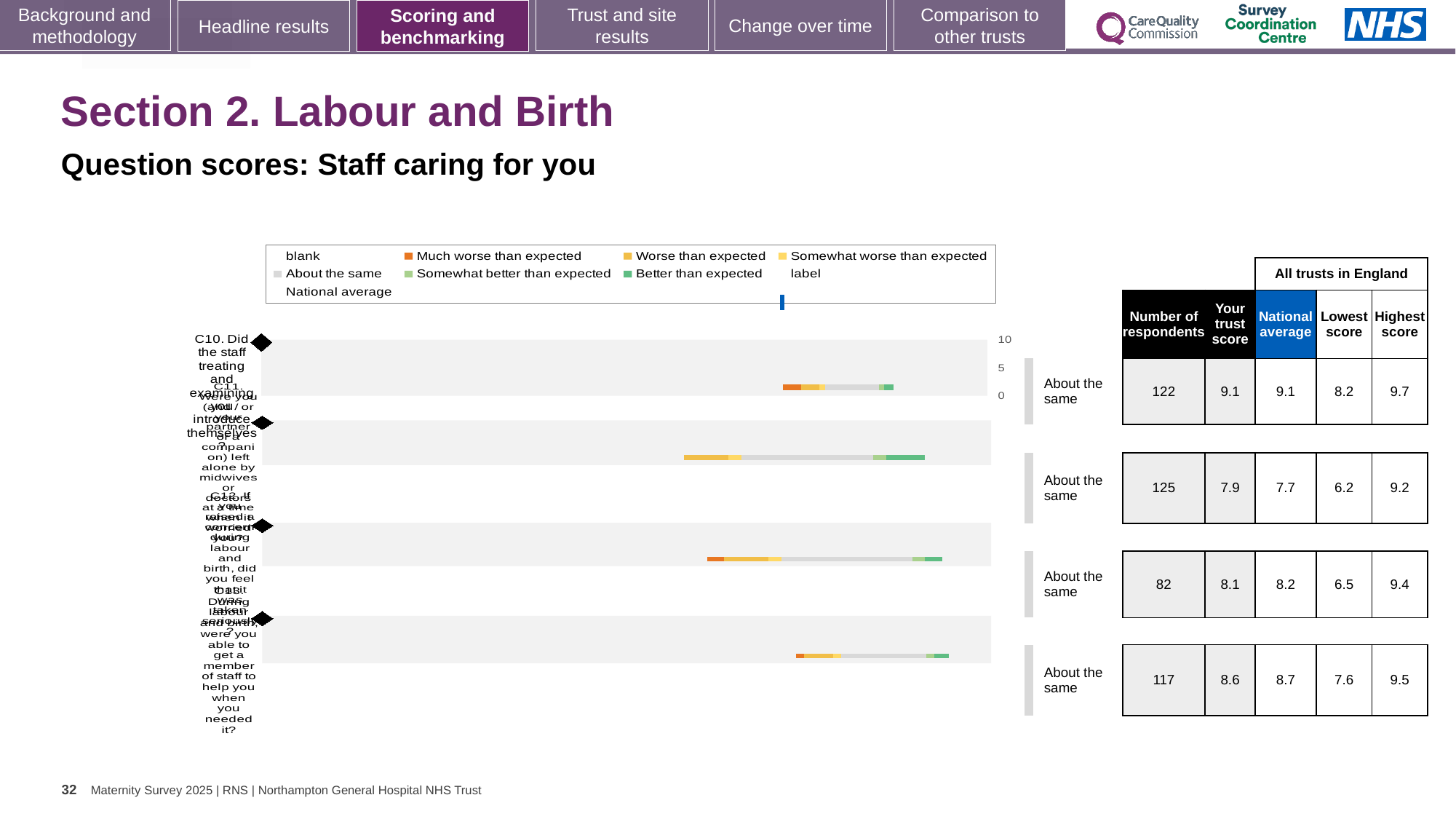
In the table beside the chart, what is the national average for the row with 125 respondents? 7.7 For the row with 125 respondents, which is larger: the trust score or the national average? the trust score In the table beside the chart, what is the highest score for the row with 82 respondents? 9.4 In the table beside the chart, what is the 'Your trust score' for the first row (122 respondents)? 9.1 What is the subtitle of the chart section on the slide? Question scores: Staff caring for you How many question rows (bars) are plotted in the chart? 4 Which row has the largest number of respondents? 125 How many of the four rows are rated 'About the same'? 4 In the table beside the chart, what is the lowest score for the row with 117 respondents? 7.6 For the first row (122 respondents), what is the difference between the highest score and the lowest score? 1.5 What kind of chart is shown on the slide? bar chart In the legend, what colour is used for 'Much worse than expected'? orange